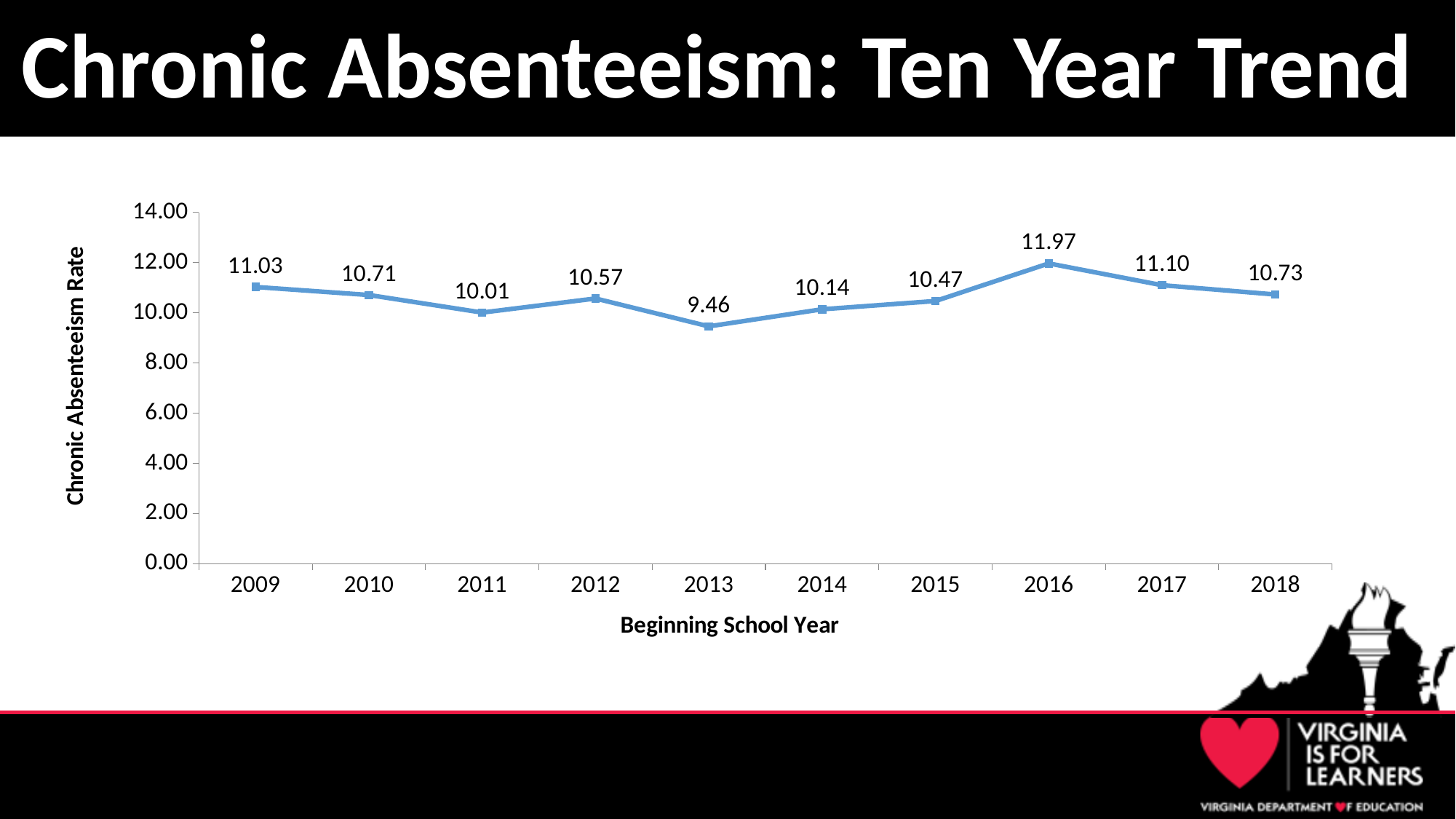
How many beginning school years are plotted on the chart? 10 Does the chronic absenteeism rate rise or fall from 2013 to 2016? rise What is the chronic absenteeism rate for beginning school year 2009? 11.03 What is the difference between the chronic absenteeism rate in 2016 and in 2013? 2.51 Which beginning school year has the lowest chronic absenteeism rate? 2013 Which beginning school year has the highest chronic absenteeism rate? 2016 What kind of chart is shown on the slide? line chart Is the chronic absenteeism rate for 2013 greater or less than 10.00? less What is the chronic absenteeism rate for beginning school year 2013? 9.46 Which year has a higher chronic absenteeism rate, 2010 or 2018? 2018 What is the chronic absenteeism rate for beginning school year 2016? 11.97 What is the label of the x axis? Beginning School Year